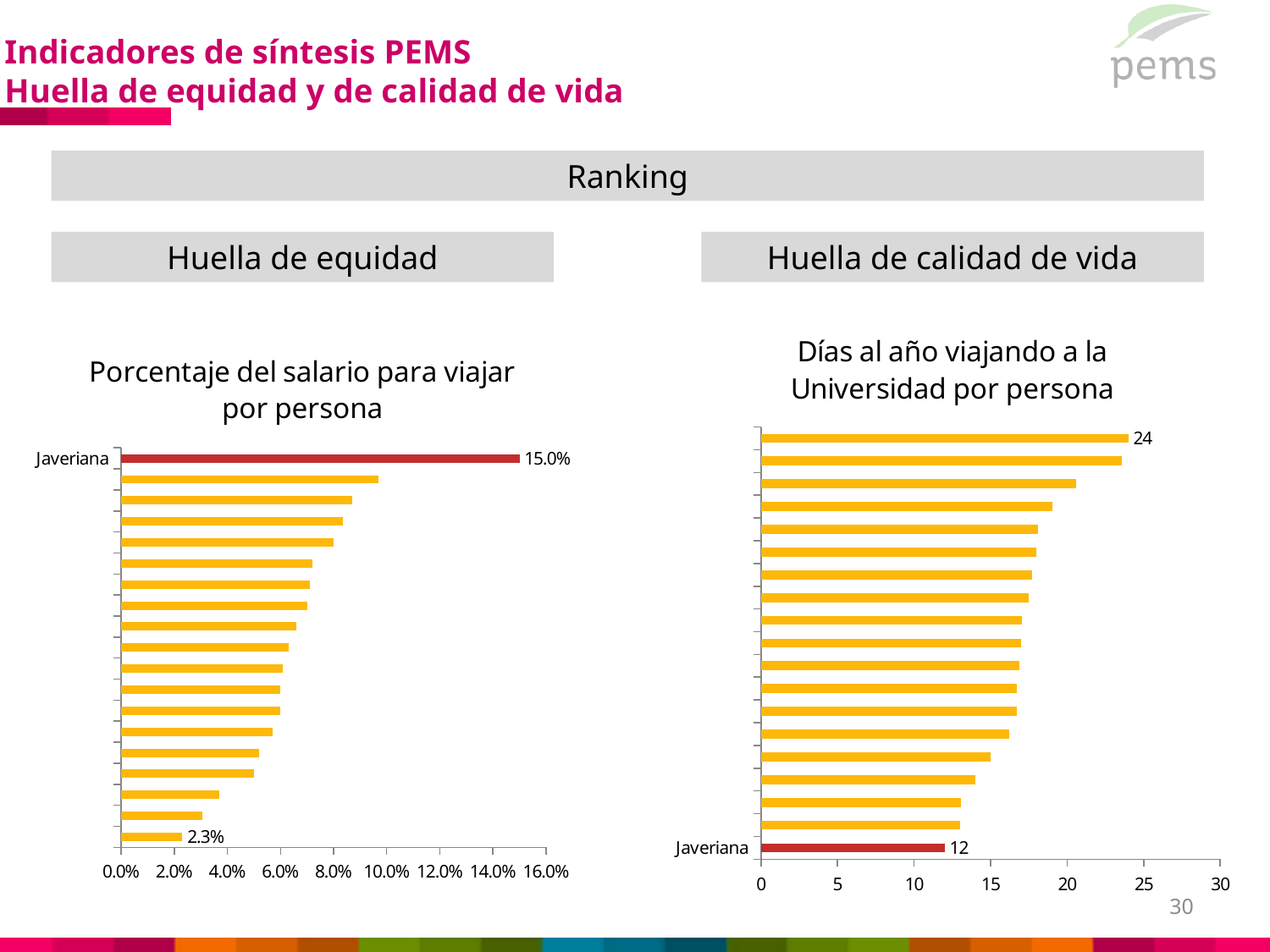
In the chart titled 'Días al año viajando a la Universidad por persona', what is the value for Javeriana? 12 In the chart titled 'Porcentaje del salario para viajar por persona', is the value of the second bar from the top greater or less than 8.0%? greater In the chart titled 'Días al año viajando a la Universidad por persona', what is the value of the highest bar at the top of the chart? 24 In the chart titled 'Días al año viajando a la Universidad por persona', what is the difference between the top bar's value and Javeriana's value? 12 In the chart titled 'Días al año viajando a la Universidad por persona', which labelled category has the lowest value? Javeriana In the chart titled 'Porcentaje del salario para viajar por persona', what is the value of the lowest bar at the bottom of the chart? 2.3% In the chart titled 'Porcentaje del salario para viajar por persona', what is the value for Javeriana? 15.0% What kind of chart is used for 'Porcentaje del salario para viajar por persona'? Bar chart In both charts on the slide, what colour is the bar for Javeriana? Red In the chart titled 'Días al año viajando a la Universidad por persona', is the value of the second bar from the bottom greater or less than 15? less In the chart titled 'Porcentaje del salario para viajar por persona', which labelled category has the highest value? Javeriana In the chart titled 'Porcentaje del salario para viajar por persona', what is the difference between Javeriana's value and the lowest bar's value? 12.7%